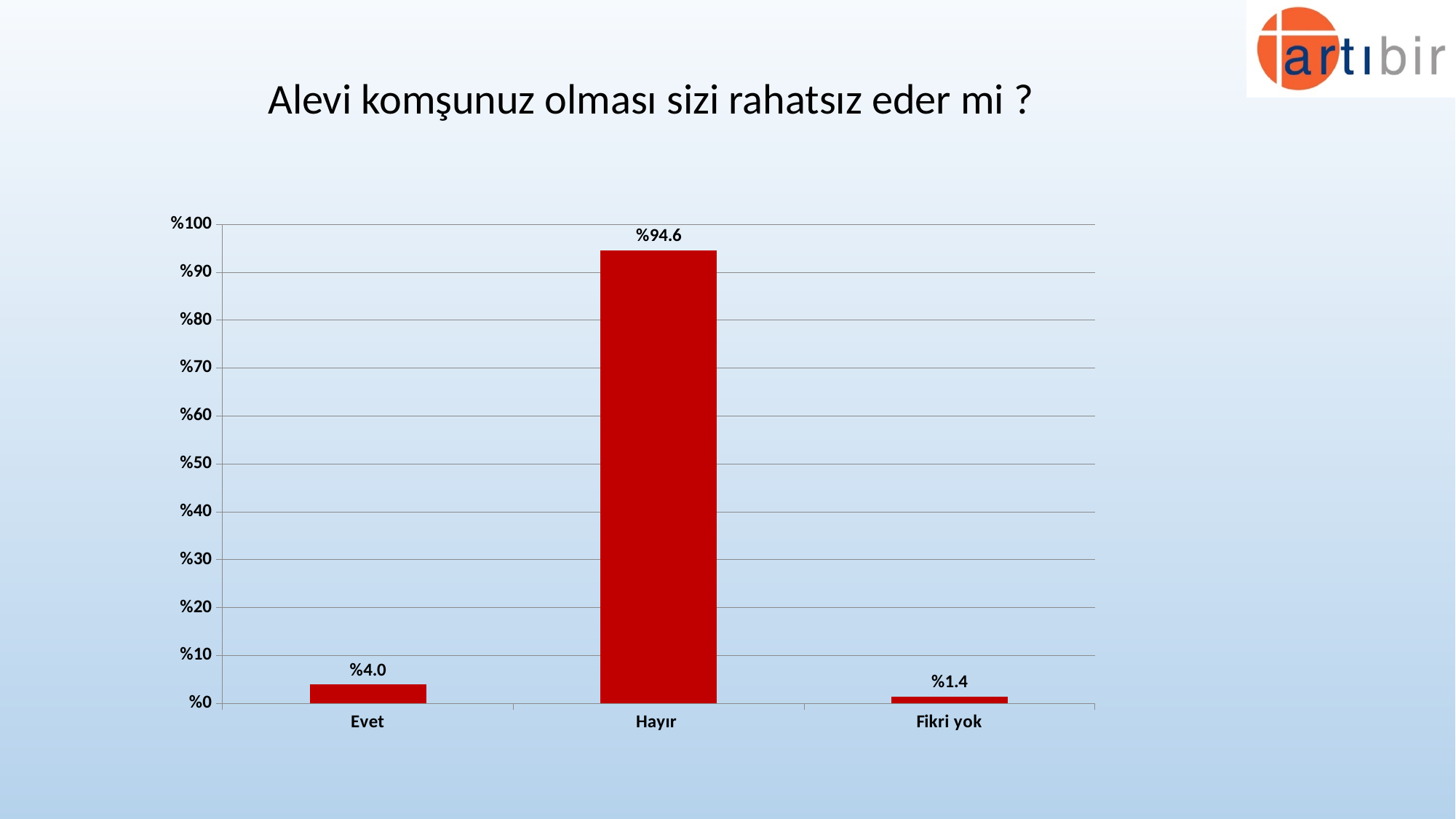
What is the value for Fikri yok? %1.4 What kind of chart is shown on the slide? bar chart How many categories are shown on the x axis? 3 Which category has the lowest value? Fikri yok What is the difference between the values for Evet and Fikri yok? %2.6 What is the value for Evet? %4.0 What is the title of the slide? Alevi komşunuz olması sizi rahatsız eder mi ? Which is larger, the value for Evet or the value for Fikri yok? Evet What is the difference between the values for Hayır and Evet? %90.6 Which category has the highest value? Hayır What is the value for Hayır? %94.6 Is the value for Hayır greater or less than %90? greater